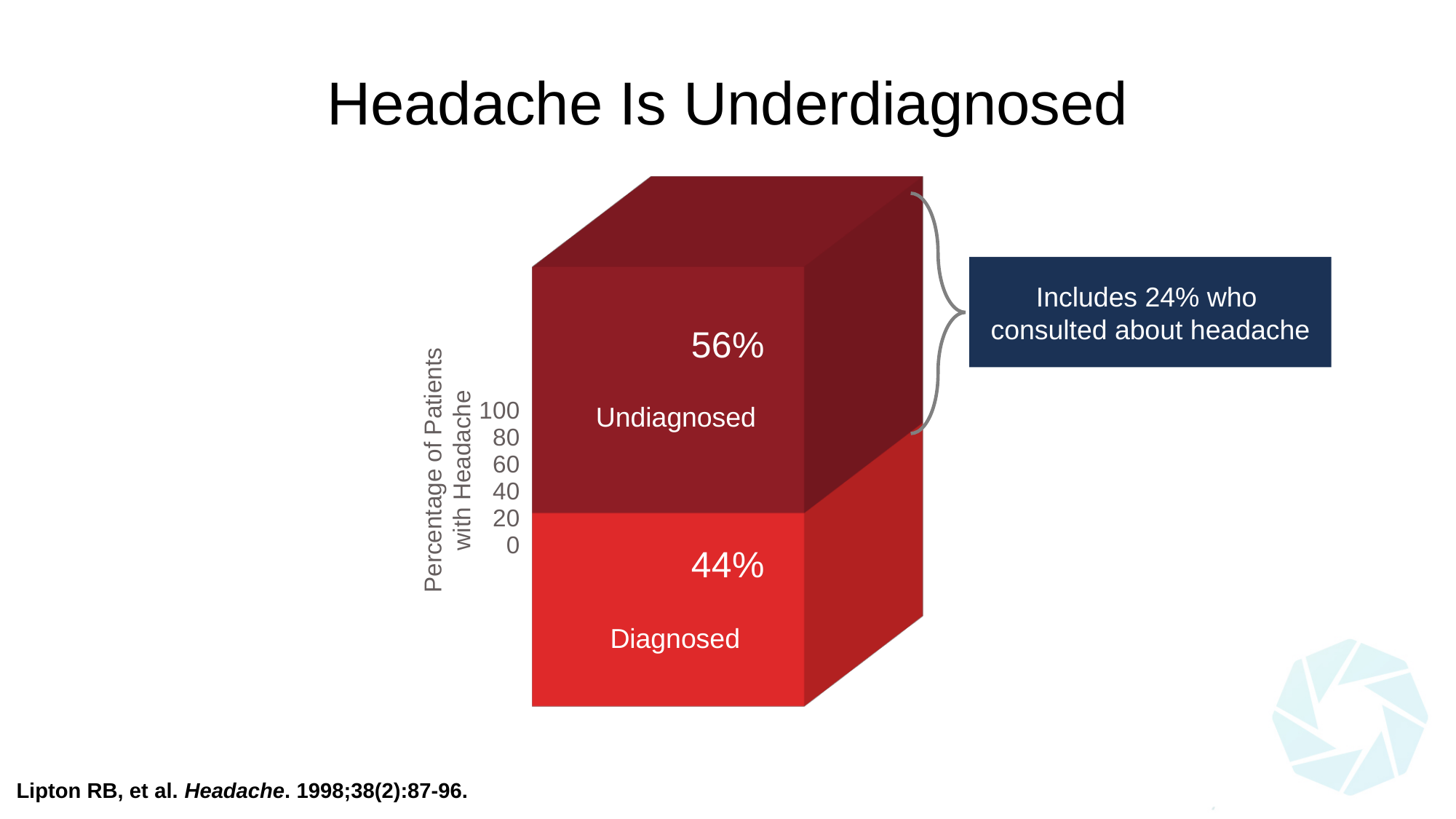
What is the title of the slide's chart? Headache Is Underdiagnosed What is the difference between the Undiagnosed and Diagnosed percentages? 12% What is the y-axis label of the chart? Percentage of Patients with Headache Which segment is larger, Undiagnosed or Diagnosed? Undiagnosed How many segments make up the stacked bar? 2 Is the Diagnosed percentage greater or less than 60? less According to the callout, what percentage of patients consulted about headache but remained undiagnosed? 24% What kind of chart is shown on the slide? Stacked bar chart Which segment has the smallest share of patients? Diagnosed What percentage of patients with headache are diagnosed? 44% What percentage of patients with headache are undiagnosed? 56% What is the total of the two stacked segments? 100%